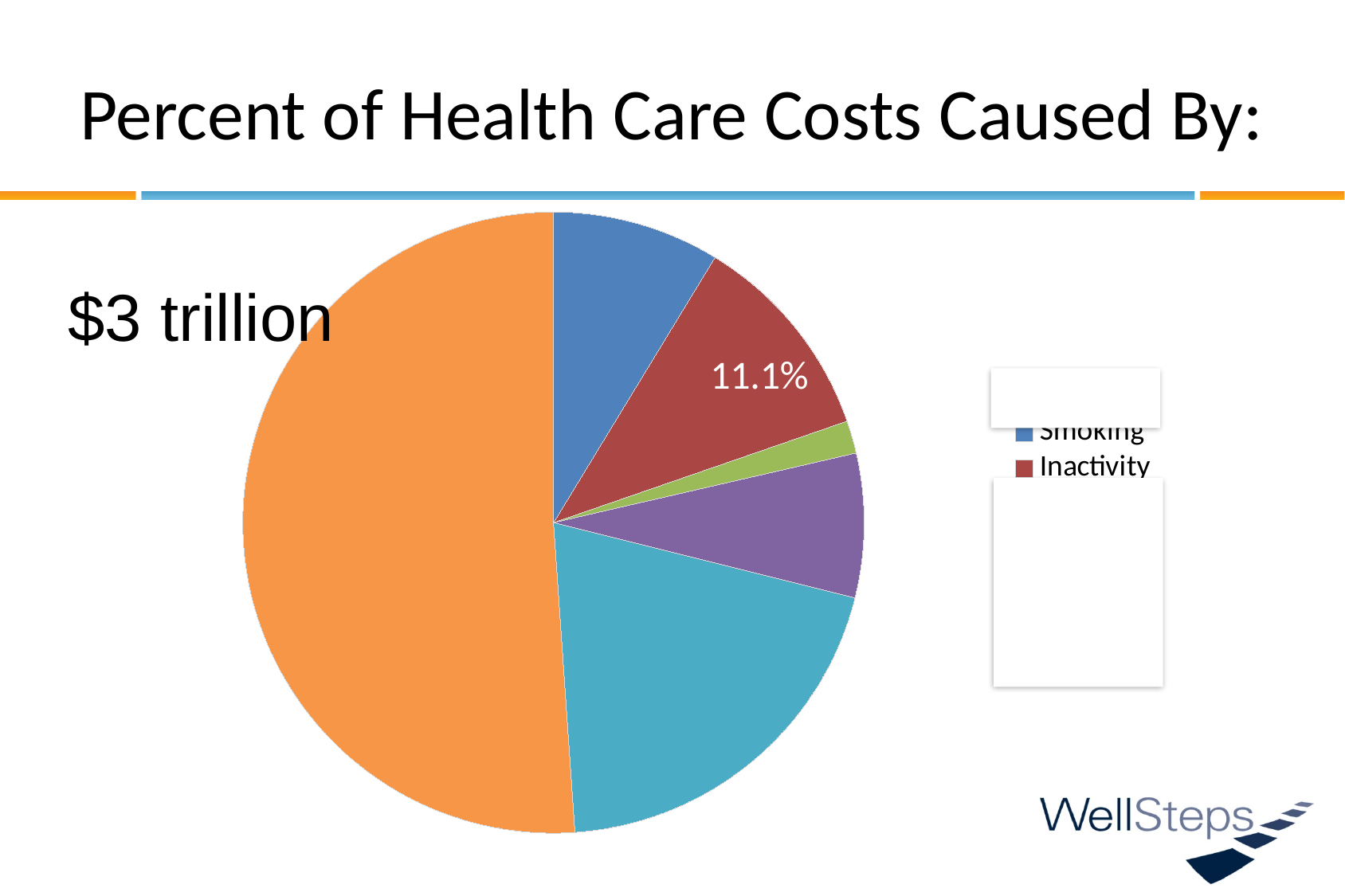
How many slices does the pie chart have? 6 What is the title of the chart? Percent of Health Care Costs Caused By: What colour is the largest slice of the pie chart? orange What colour is the smallest slice of the pie chart? green What kind of chart is shown on the slide? pie chart What percentage of health care costs is attributed to Inactivity? 11.1% Which colour represents Smoking in the legend? blue